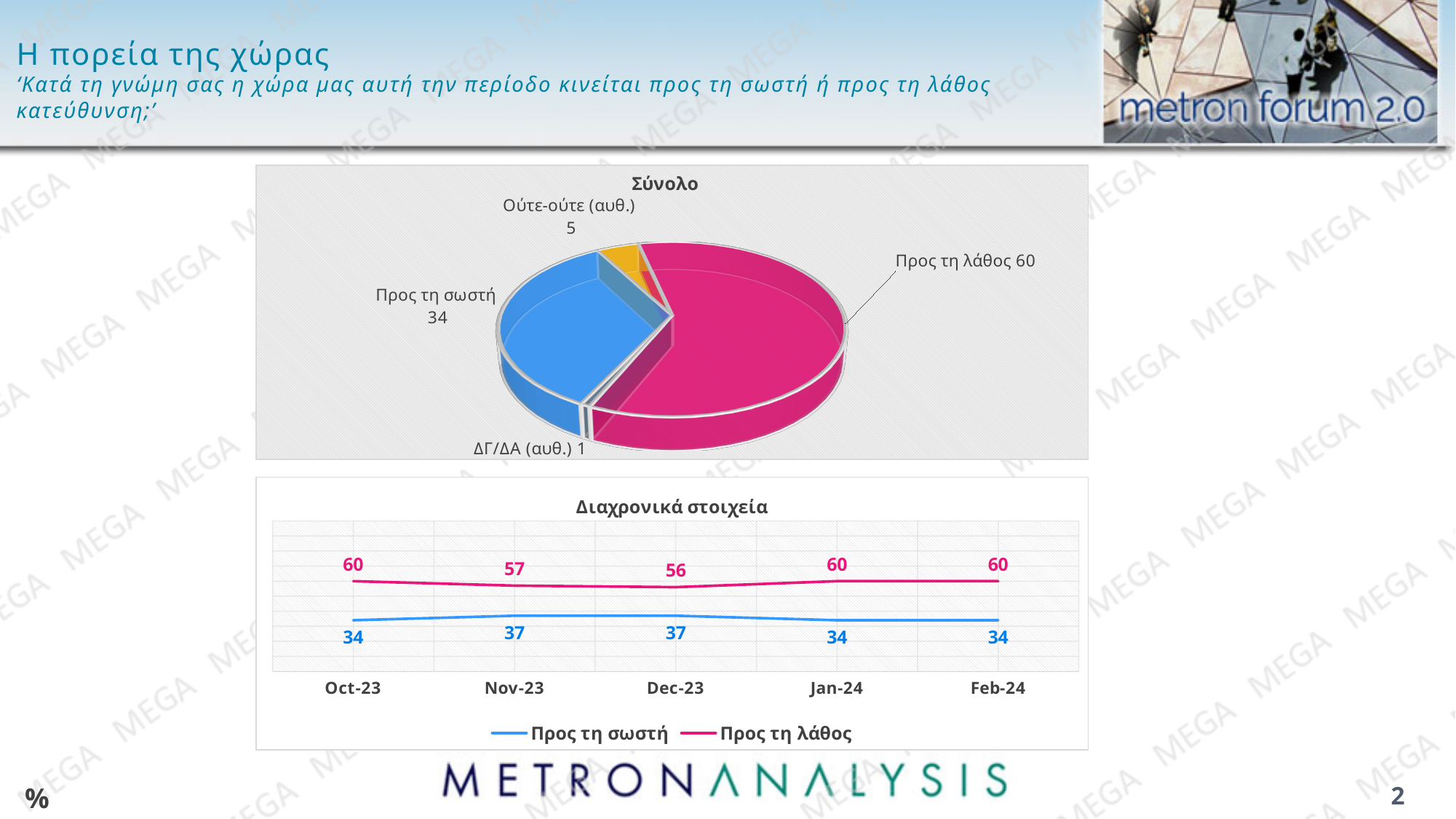
In the pie chart titled 'Σύνολο', which category has the smallest slice? ΔΓ/ΔΑ (αυθ.) In the chart titled 'Διαχρονικά στοιχεία', what is the value for 'Προς τη λάθος' in Dec-23? 56 In the pie chart titled 'Σύνολο', what is the difference between 'Προς τη λάθος' and 'Προς τη σωστή'? 26 In the pie chart titled 'Σύνολο', how many slices are there? 4 What kind of chart is the one titled 'Διαχρονικά στοιχεία'? Line chart In the chart titled 'Διαχρονικά στοιχεία', how many time points are shown on the x axis? 5 In the chart titled 'Διαχρονικά στοιχεία', how many series does the legend list? 2 In the pie chart titled 'Σύνολο', what is the value for 'Προς τη λάθος'? 60 In the chart titled 'Διαχρονικά στοιχεία', what is the value for 'Προς τη σωστή' in Nov-23? 37 In the pie chart titled 'Σύνολο', what is the value for 'Προς τη σωστή'? 34 In the pie chart titled 'Σύνολο', which category has the largest slice? Προς τη λάθος In the chart titled 'Διαχρονικά στοιχεία', which series is higher in Jan-24, 'Προς τη σωστή' or 'Προς τη λάθος'? Προς τη λάθος